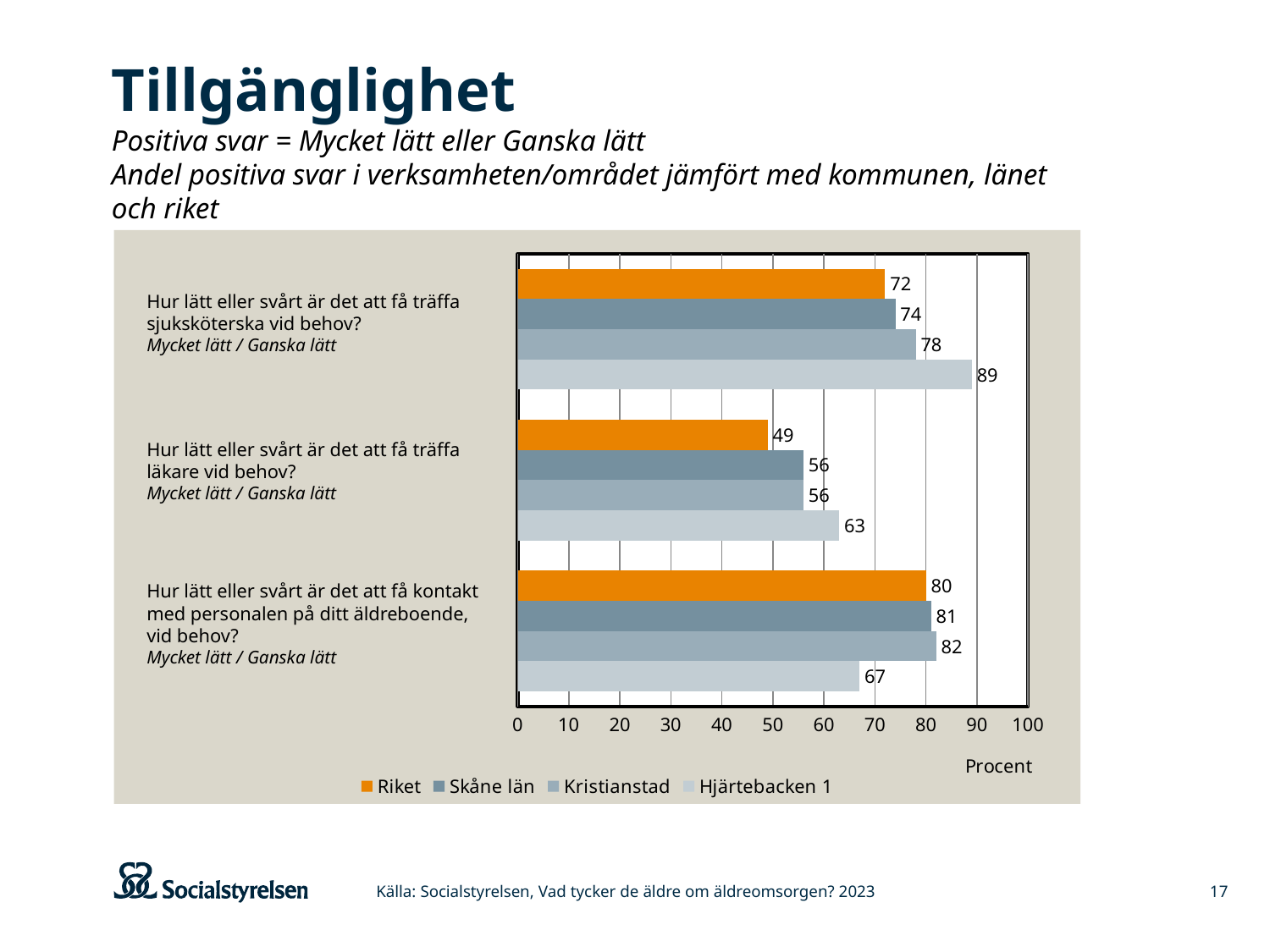
What unit label is shown below the x axis of the chart? Procent How many series does the legend list? 4 What is the difference between Hjärtebacken 1 and Riket on the question about meeting a nurse when needed? 17 Which series has the highest value on the question about meeting a nurse when needed? Hjärtebacken 1 What is the value for Riket on the question about meeting a doctor when needed (träffa läkare vid behov)? 49 Which series has the lowest value on the question about getting in contact with staff at the care home? Hjärtebacken 1 Which is larger on the question about meeting a doctor when needed: Hjärtebacken 1 or Skåne län? Hjärtebacken 1 What is the value for Hjärtebacken 1 on the question about meeting a nurse when needed (träffa sjuksköterska vid behov)? 89 How many question categories are shown on the chart? 3 What kind of chart is shown on the slide? Bar chart What is the difference between Kristianstad and Hjärtebacken 1 on the question about getting in contact with staff at the care home? 15 What is the value for Kristianstad on the question about getting in contact with staff at the care home (kontakt med personalen)? 82